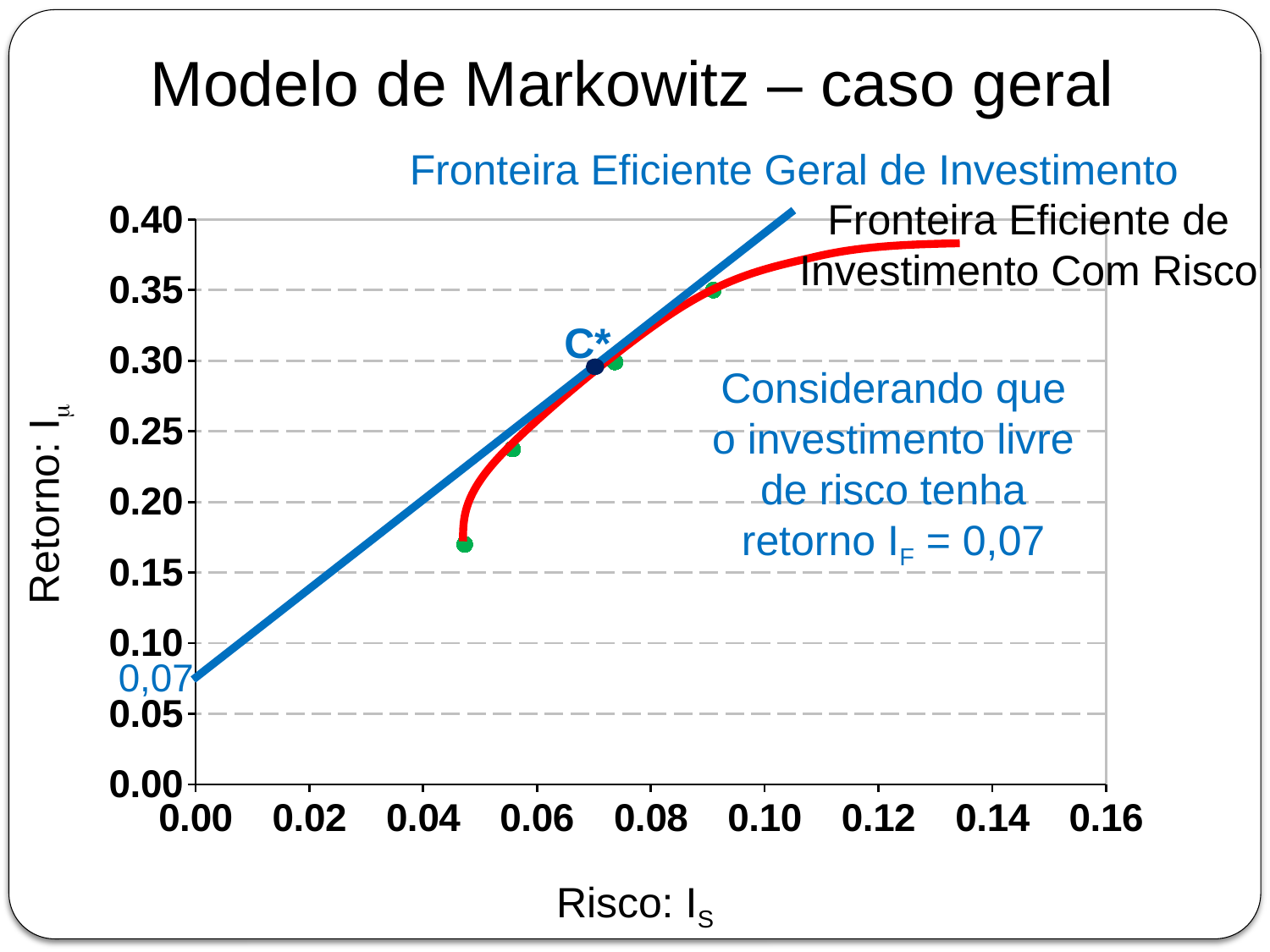
Is the risk at point C* greater or less than 0.08? less At what return value does the blue line meet the y axis (risk 0.00)? 0,07 How many green points are marked on the red curve? 4 Is the return of the highest green point on the red curve greater or less than 0.30? greater Which has the higher return, the leftmost green point or the rightmost green point on the red curve? the rightmost green point Which line does the legend text 'Fronteira Eficiente Geral de Investimento' refer to, the straight blue line or the curved red line? the straight blue line What is the highest value shown on the y axis? 0.40 Does the red curve rise or fall as risk increases along the x axis? rise What is the label of the x axis? Risco: I_S Is the return at point C* greater or less than 0.25? greater What kind of chart is shown on the slide? line chart